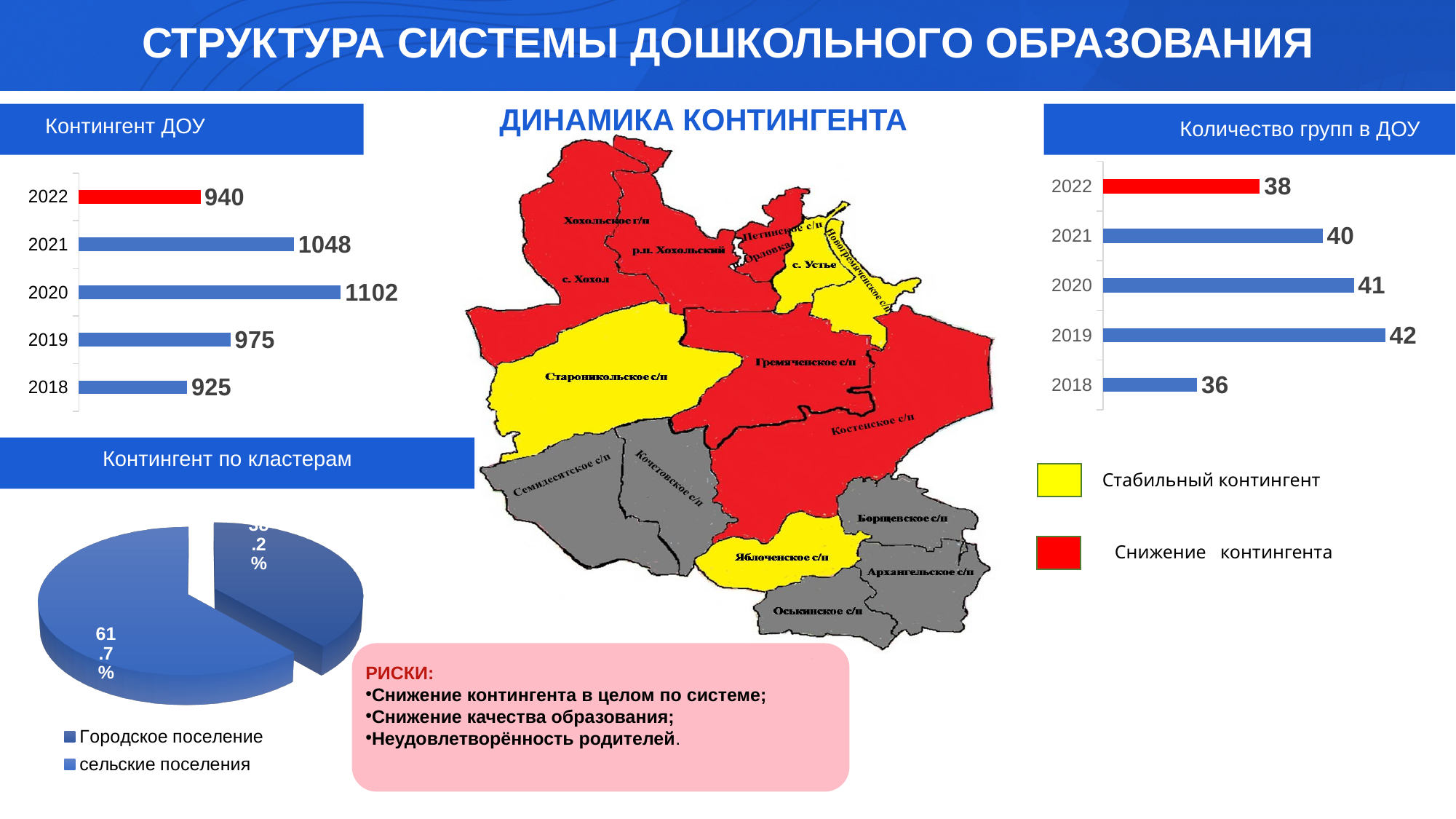
In the 'Количество групп в ДОУ' chart, what is the difference between the values for 2019 and 2018? 6 In the 'Количество групп в ДОУ' chart, which is larger, the value for 2021 or the value for 2022? 2021 In the 'Количество групп в ДОУ' chart, what is the value for 2019? 42 In the 'Количество групп в ДОУ' chart, which year has the lowest value? 2018 What kind of chart is 'Контингент по кластерам'? pie chart In the 'Контингент ДОУ' chart, what is the value for 2022? 940 In the 'Контингент ДОУ' chart, what is the difference between the values for 2020 and 2021? 54 In the 'Контингент ДОУ' chart, which year has the lowest value? 2018 In the 'Контингент по кластерам' pie chart, what is the share of the largest slice? 61.7% In the 'Контингент ДОУ' chart, which year has the highest value? 2020 In the 'Контингент ДОУ' chart, how many years are shown? 5 How many entries does the legend of the 'Контингент по кластерам' chart list? 2